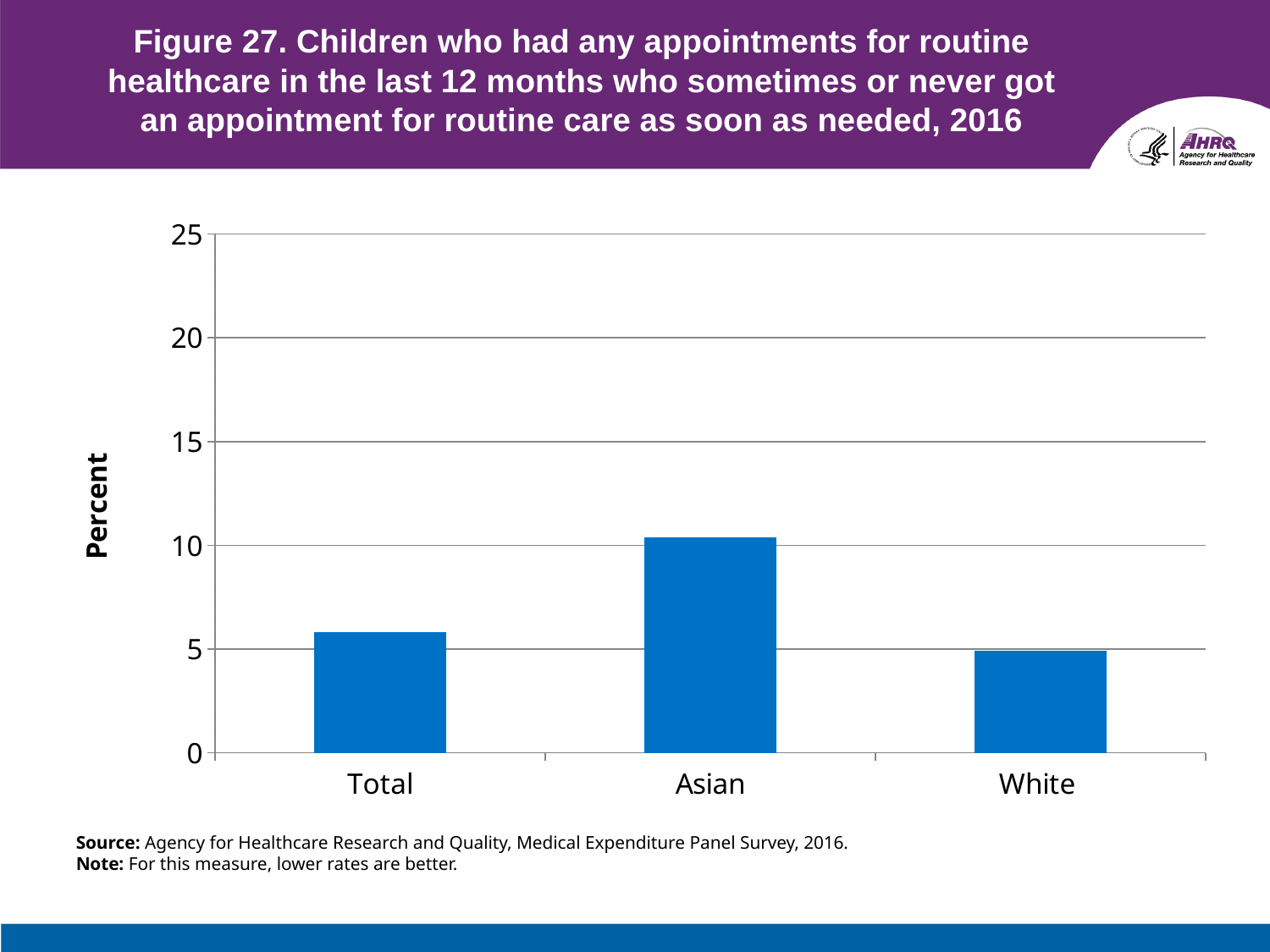
What is the label on the vertical axis of the chart? Percent What is the maximum value shown on the vertical axis? 25 How many categories are plotted on the chart? 3 Is the value for Asian greater or less than 15? less Is the value for White greater or less than 10? less Is the value for Total greater or less than 10? less Which is larger, the value for Asian or the value for Total? Asian What kind of chart is shown on the slide? bar chart Which is larger, the value for Total or the value for White? Total Which category has the lowest value? White Which category has the highest value? Asian